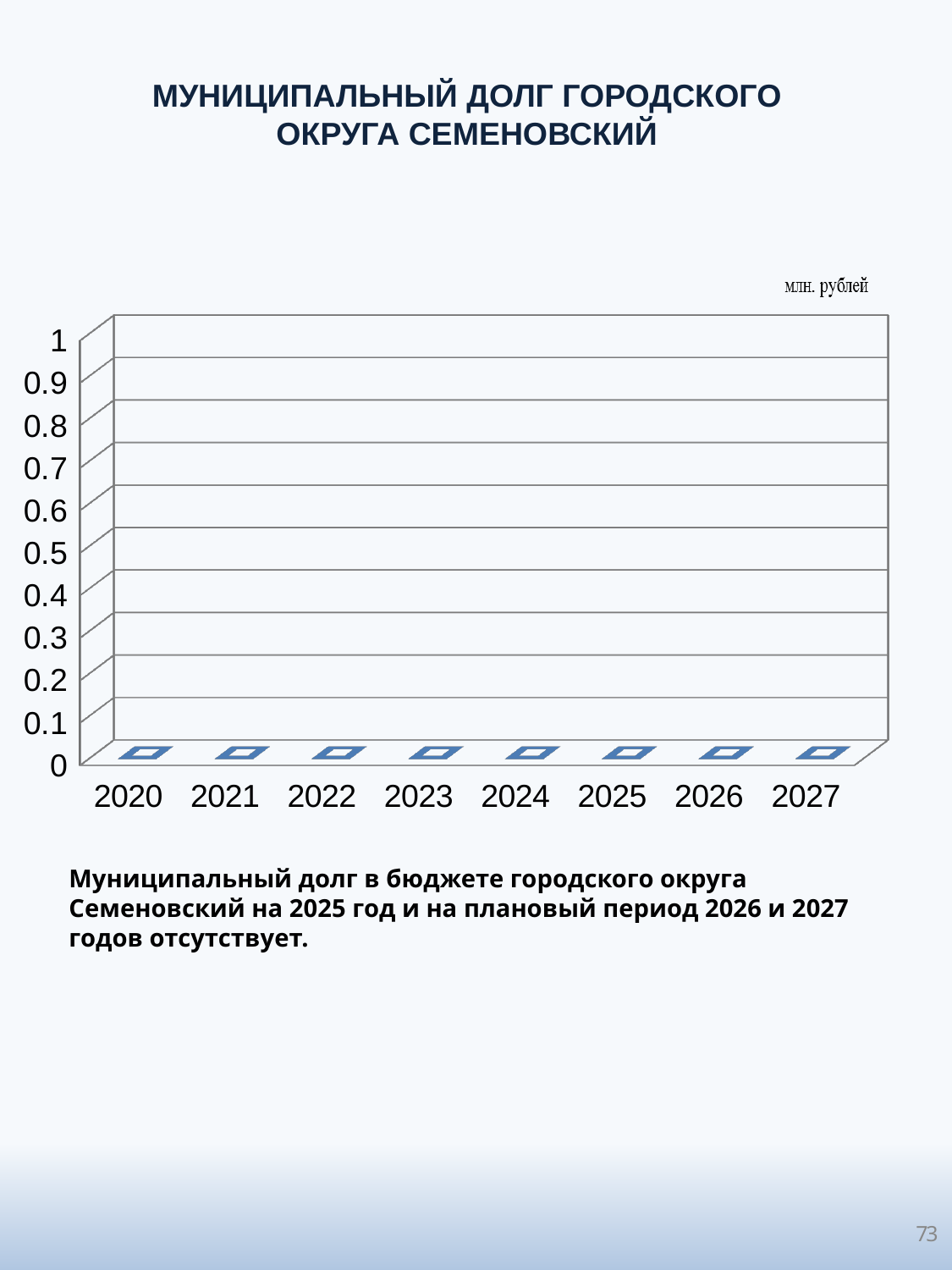
What is the difference between the values for 2024 and 2021? 0 What is the value of municipal debt for 2020? 0 How many years are shown on the x axis of the chart? 8 Do the values rise, fall or stay the same from 2020 to 2027? stay the same What kind of chart is shown on the slide? bar chart What is the first year shown on the x axis? 2020 What is the highest value shown on the y axis? 1 Is the value for 2026 greater or less than 0.1? less What is the value of municipal debt for 2027? 0 What is the last year shown on the x axis? 2027 What is the value of municipal debt for 2025? 0 Is the value for 2023 greater or less than 0.5? less